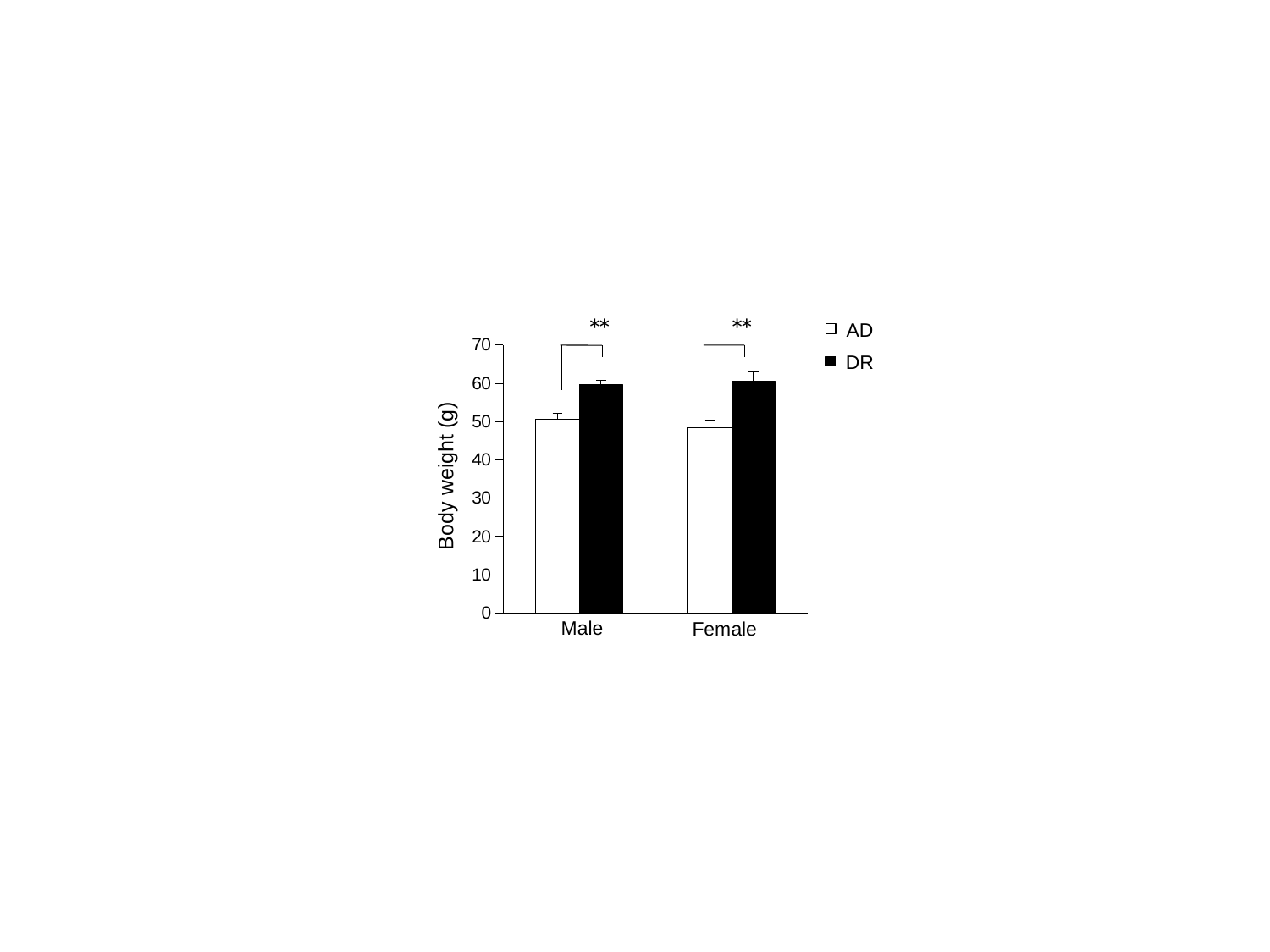
What kind of chart is shown on the slide? bar chart Which series is drawn with black bars? DR For Male, which series has the larger value, AD or DR? DR Is the DR value for Female greater or less than 70? less Is the DR value for Male greater or less than 70? less Is the DR value for Male greater or less than 50? greater How many series does the legend list? 2 How many categories are shown on the x axis? 2 For Female, which series has the larger value, AD or DR? DR What is the label of the y axis? Body weight (g)